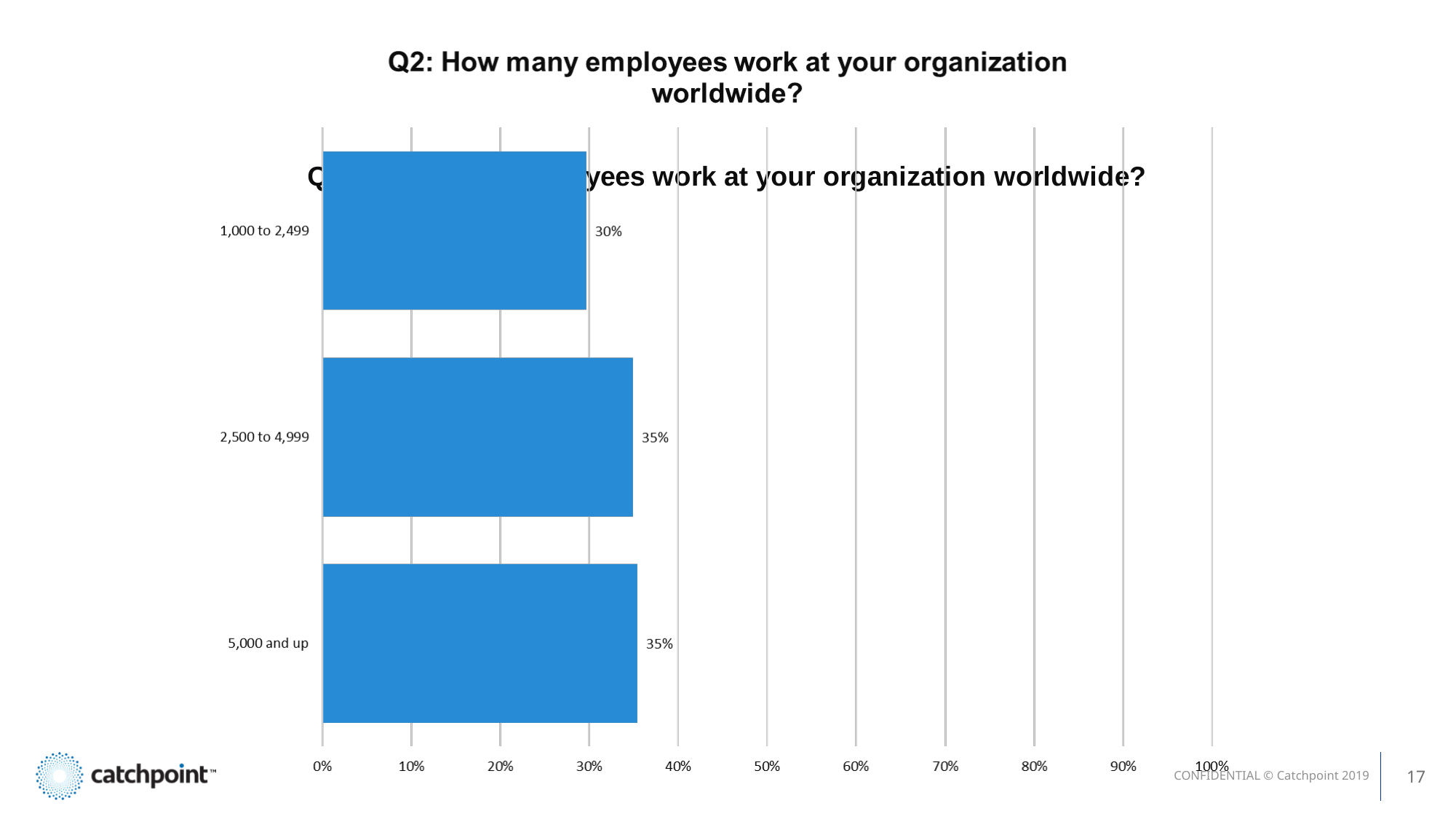
What is the value shown for the 2,500 to 4,999 category? 35% What kind of chart is shown on the slide? bar chart How many categories are shown in the chart? 3 What percentage of respondents have 1,000 to 2,499 employees at their organization? 30% Which category has the lowest value? 1,000 to 2,499 What is the total of the three values shown in the chart? 100% What is the difference between the values for 2,500 to 4,999 and 1,000 to 2,499? 5% Is the value for 1,000 to 2,499 greater or less than 40%? less Which is larger, the value for 2,500 to 4,999 or the value for 1,000 to 2,499? 2,500 to 4,999 What is the value shown for the 5,000 and up category? 35% What is the title of the chart? Q2: How many employees work at your organization worldwide? Is the value for 5,000 and up greater or less than 20%? greater